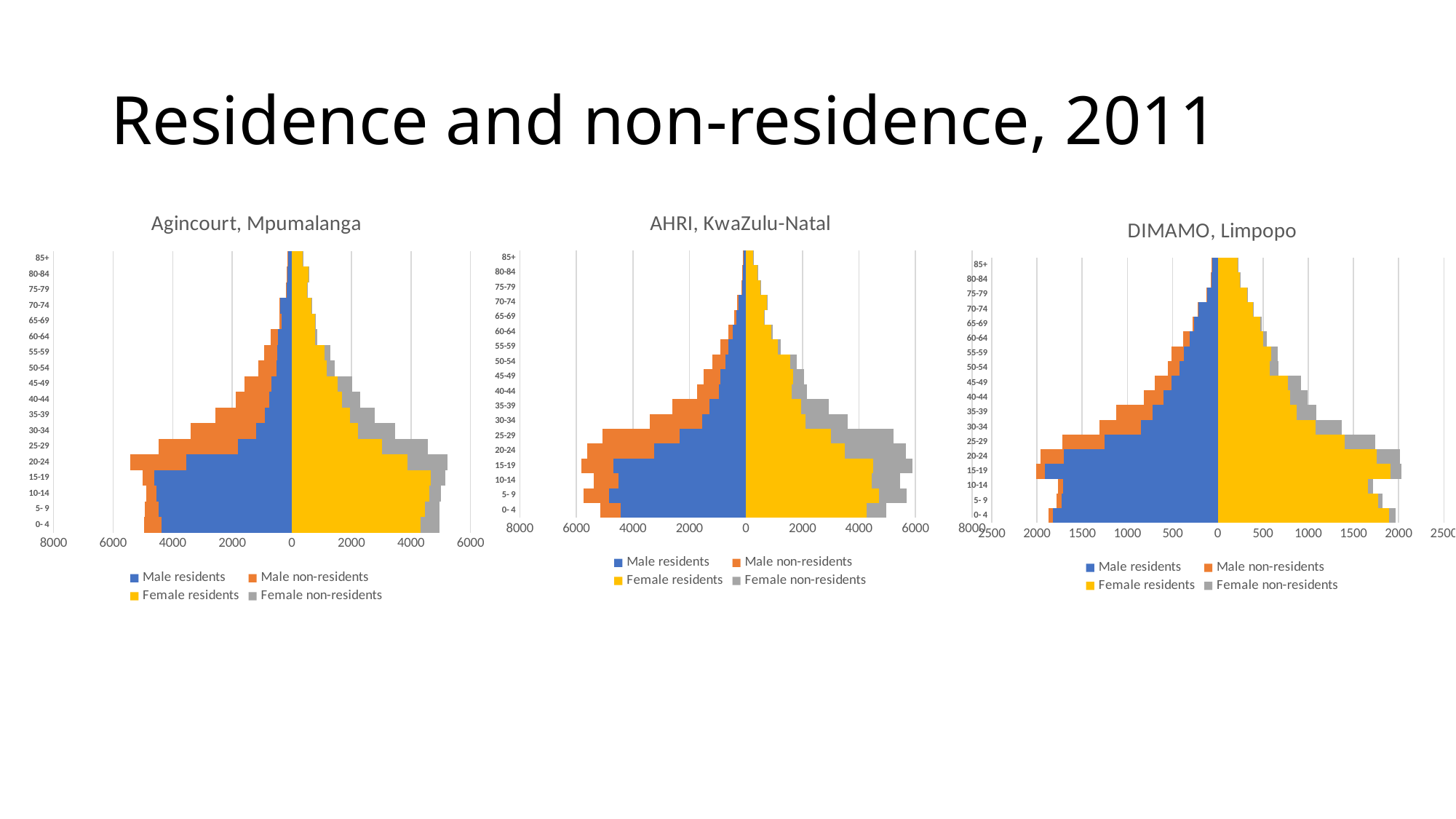
In the AHRI, KwaZulu-Natal chart, is the value for Male residents aged 0-4 greater or less than 4000? greater What kind of chart is the Agincourt, Mpumalanga chart? Bar chart In the Agincourt, Mpumalanga chart, is the value for Female residents aged 15-19 greater or less than 4000? greater What is the title of the chart on the right of the slide? DIMAMO, Limpopo In the AHRI, KwaZulu-Natal chart, which colour represents Female non-residents? Grey In the Agincourt, Mpumalanga chart, which age group has the shortest bars? 85+ In the DIMAMO, Limpopo chart, is the value for Male residents aged 0-4 greater or less than 1500? greater How many age groups are shown on the vertical axis of the DIMAMO, Limpopo chart? 18 In the Agincourt, Mpumalanga chart, which is larger: Male non-residents aged 20-24 or Male non-residents aged 0-4? Male non-residents aged 20-24 How many series does the legend of the AHRI, KwaZulu-Natal chart list? 4 In the AHRI, KwaZulu-Natal chart, do the Male residents values generally rise or fall as age increases from 0-4 to 85+? Fall